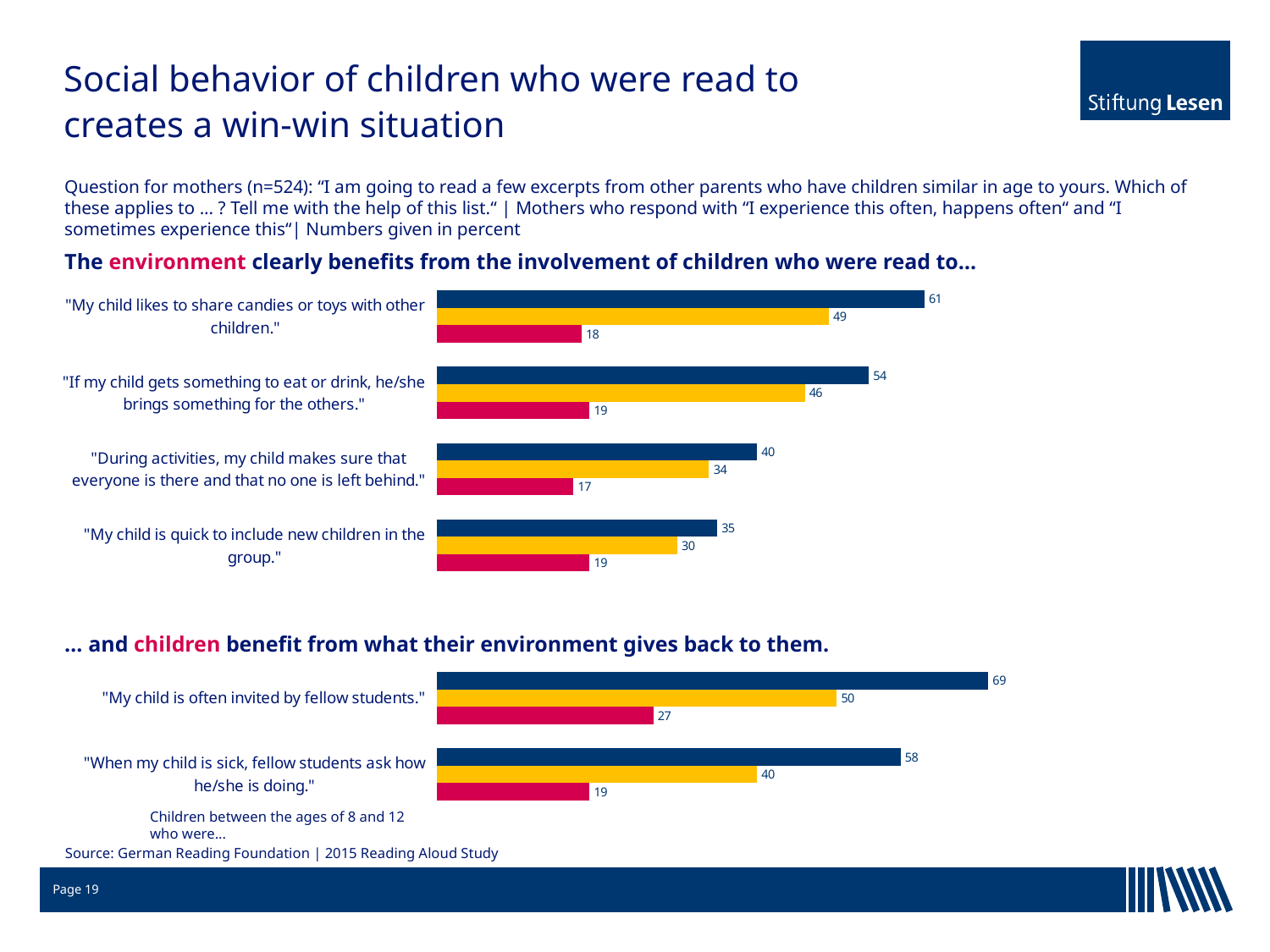
In the top chart, what is the value of the red bar for "During activities, my child makes sure that everyone is there and that no one is left behind."? 17 In the top chart, which statement has the highest dark blue bar value? "My child likes to share candies or toys with other children." How many statements (categories) are shown in the top chart? 4 In the bottom chart, what is the difference between the dark blue bar values of the two statements? 11 How many bars are shown for each statement in the bottom chart? 3 In the top chart, which statement has the lowest yellow bar value? "My child is quick to include new children in the group." In the top chart, what is the value of the dark blue bar for "My child likes to share candies or toys with other children."? 61 In the bottom chart, what is the value of the yellow bar for "When my child is sick, fellow students ask how he/she is doing."? 40 In the bottom chart, what is the value of the red bar for "My child is often invited by fellow students."? 27 What type of chart is used on this slide? Bar chart In the top chart, what is the difference between the dark blue and yellow bar values for "If my child gets something to eat or drink, he/she brings something for the others."? 8 In the top chart, which is larger: the yellow bar for "My child likes to share candies or toys with other children." or the dark blue bar for "During activities, my child makes sure that everyone is there and that no one is left behind."? The yellow bar for "My child likes to share candies or toys with other children." (49)